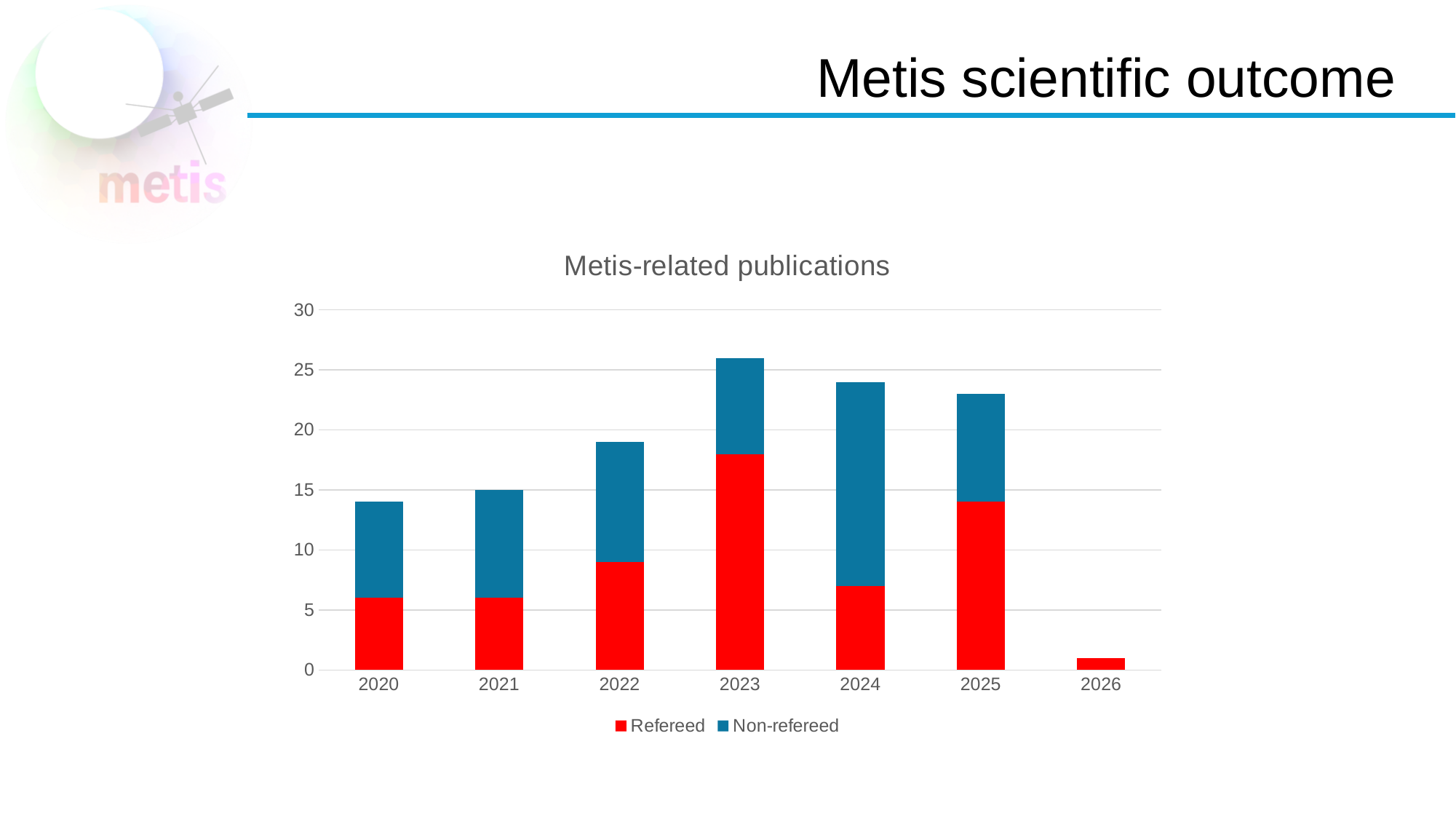
Is the number of refereed publications in 2023 greater or less than 15? greater How many years are shown on the x axis? 7 Which year has more total publications, 2020 or 2024? 2024 Which year has the highest total number of publications? 2023 Which year has the lowest total number of publications? 2026 What is the title of the chart? Metis-related publications Is the total number of publications in 2023 greater or less than 25? greater Do total publications rise or fall from 2020 to 2023? rise Is the total number of publications in 2020 greater or less than 15? less What is the total number of publications in 2021? 15 What type of chart is shown on the slide? Stacked bar chart How many series does the legend list? 2